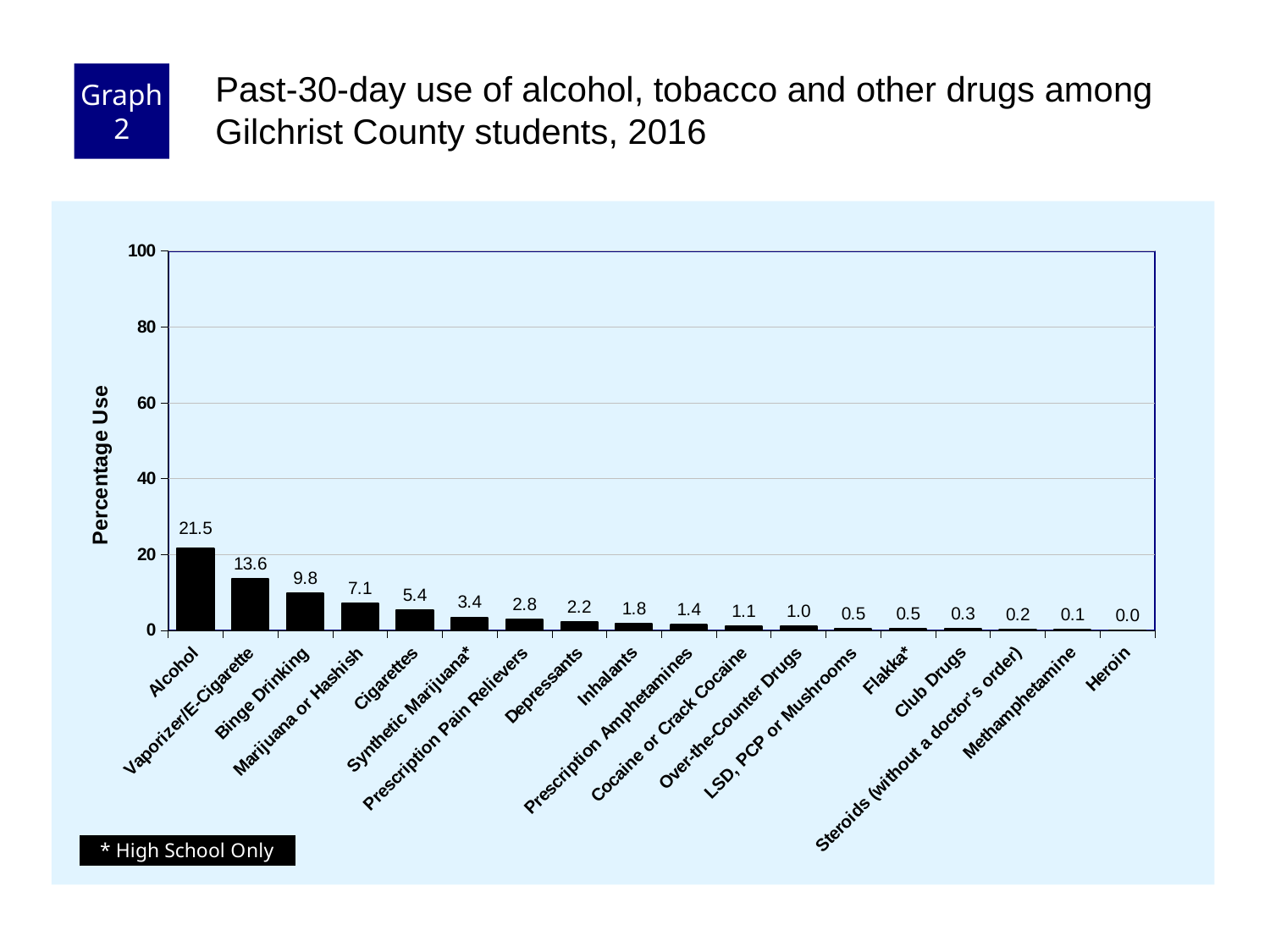
What kind of chart is shown on the slide? Bar chart How many categories are shown on the x axis? 18 Which category has the lowest percentage use? Heroin What is the percentage use for Heroin? 0.0 What is the percentage use for Alcohol? 21.5 What is the difference in percentage use between Alcohol and Vaporizer/E-Cigarette? 7.9 What is the label of the y axis? Percentage Use What is the percentage use for Synthetic Marijuana*? 3.4 Which has a higher percentage use, Cigarettes or Marijuana or Hashish? Marijuana or Hashish Is the value for Vaporizer/E-Cigarette greater or less than 20? less Which category has the highest percentage use? Alcohol What is the percentage use for Binge Drinking? 9.8